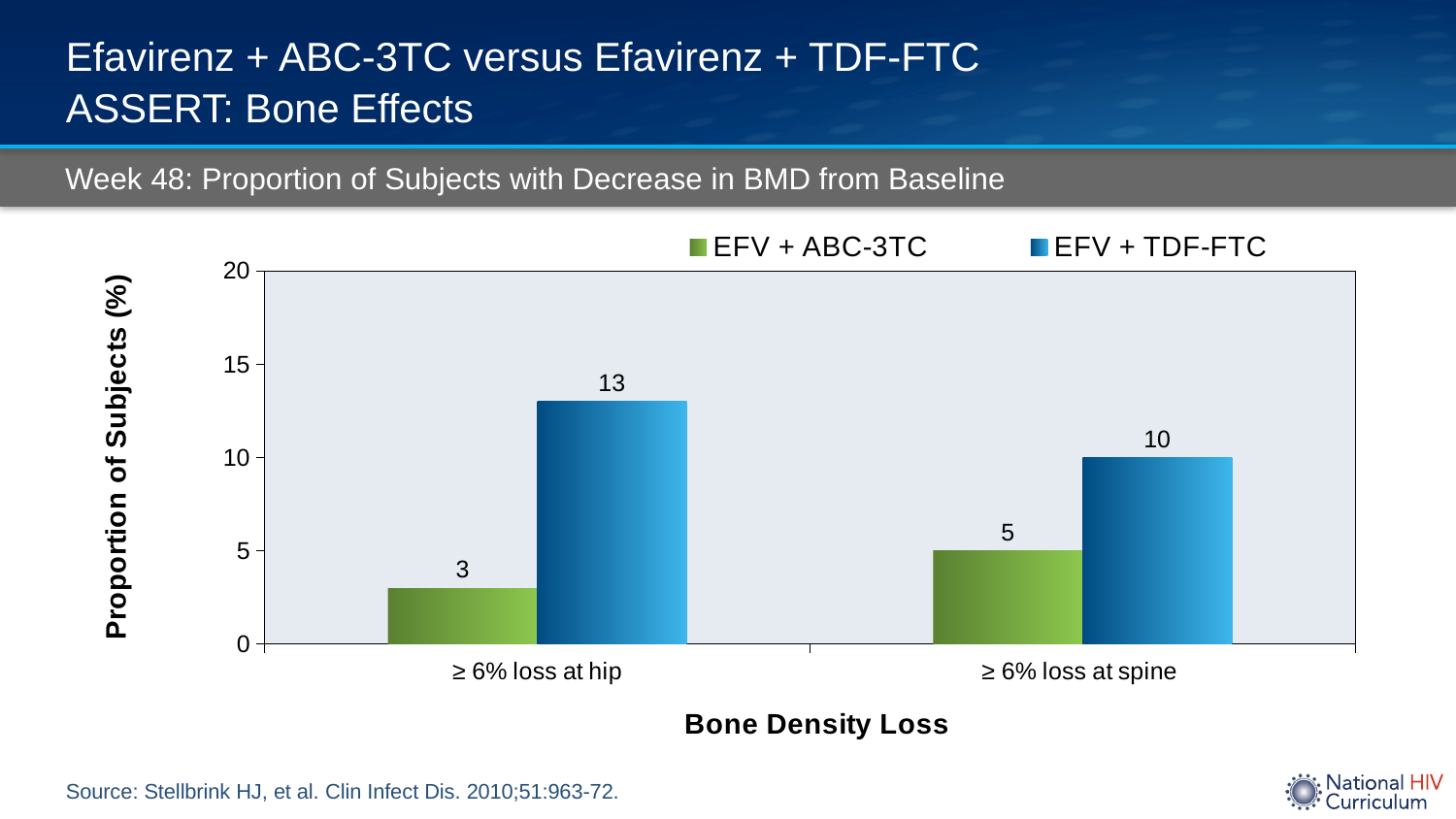
How many series does the legend list? 2 What is the value for EFV + ABC-3TC in the "≥ 6% loss at hip" category? 3 How many categories are shown on the x axis? 2 Which bar has the lowest value on the chart? EFV + ABC-3TC, ≥ 6% loss at hip Which bar has the highest value on the chart? EFV + TDF-FTC, ≥ 6% loss at hip What is the value for EFV + TDF-FTC in the "≥ 6% loss at hip" category? 13 Which is larger: the EFV + TDF-FTC value at the hip or the EFV + TDF-FTC value at the spine? EFV + TDF-FTC at the hip What is the value for EFV + TDF-FTC in the "≥ 6% loss at spine" category? 10 What is the difference between the EFV + TDF-FTC and EFV + ABC-3TC values for "≥ 6% loss at hip"? 10 What is the difference between the EFV + TDF-FTC and EFV + ABC-3TC values for "≥ 6% loss at spine"? 5 What kind of chart is shown on the slide? Bar chart What is the value for EFV + ABC-3TC in the "≥ 6% loss at spine" category? 5